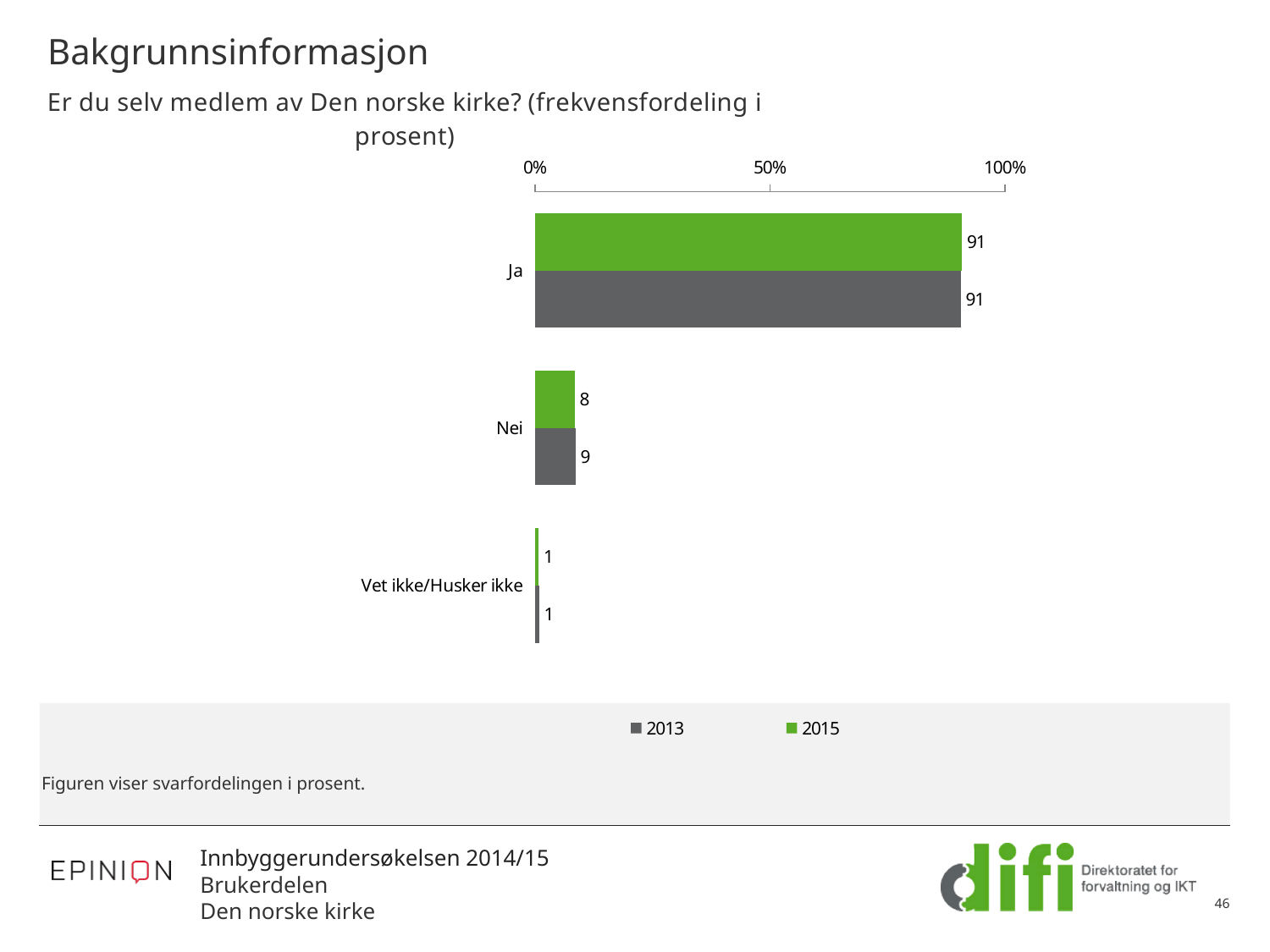
Which category has the highest value in the 2015 series? Ja What is the value for "Nei" in the 2015 series? 8 Is the value for "Ja" in 2013 greater or less than 50%? greater How many series does the legend list? 2 What is the difference between the 2013 and 2015 values for "Nei"? 1 Which category has the lowest value in the 2013 series? Vet ikke/Husker ikke What is the value for "Ja" in the 2015 series? 91 How many categories are shown on the chart? 3 What is the value for "Vet ikke/Husker ikke" in the 2013 series? 1 Which is larger for "Nei": the 2013 value or the 2015 value? 2013 What is the value for "Nei" in the 2013 series? 9 What kind of chart is shown on the slide? bar chart